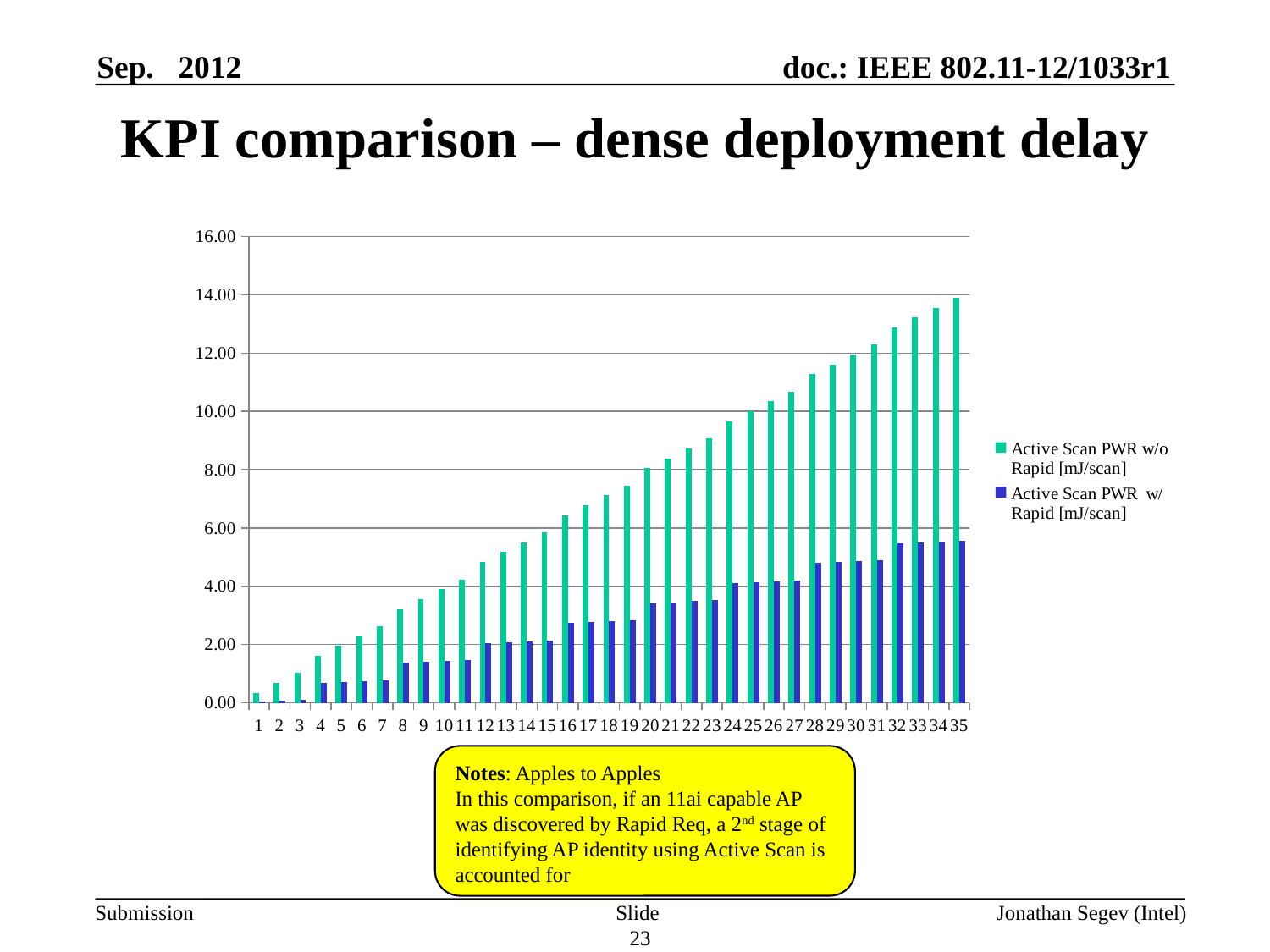
At category 30, which series has the larger value: Active Scan PWR w/o Rapid [mJ/scan] or Active Scan PWR w/ Rapid [mJ/scan]? Active Scan PWR w/o Rapid [mJ/scan] What is the highest value shown on the y axis? 16.00 Do the values for Active Scan PWR w/o Rapid [mJ/scan] rise or fall as the category number increases from 1 to 35? rise Is the value for Active Scan PWR w/o Rapid [mJ/scan] at category 35 greater or less than 12.00? greater Which category has the lowest value for Active Scan PWR w/o Rapid [mJ/scan]? 1 How many categories are shown along the x axis? 35 Is the value for Active Scan PWR w/ Rapid [mJ/scan] at category 10 greater or less than 2.00? less Is the value for Active Scan PWR w/o Rapid [mJ/scan] at category 28 greater or less than 10.00? greater What kind of chart is shown on the slide? bar chart Which category has the highest value for Active Scan PWR w/o Rapid [mJ/scan]? 35 How many series does the legend list? 2